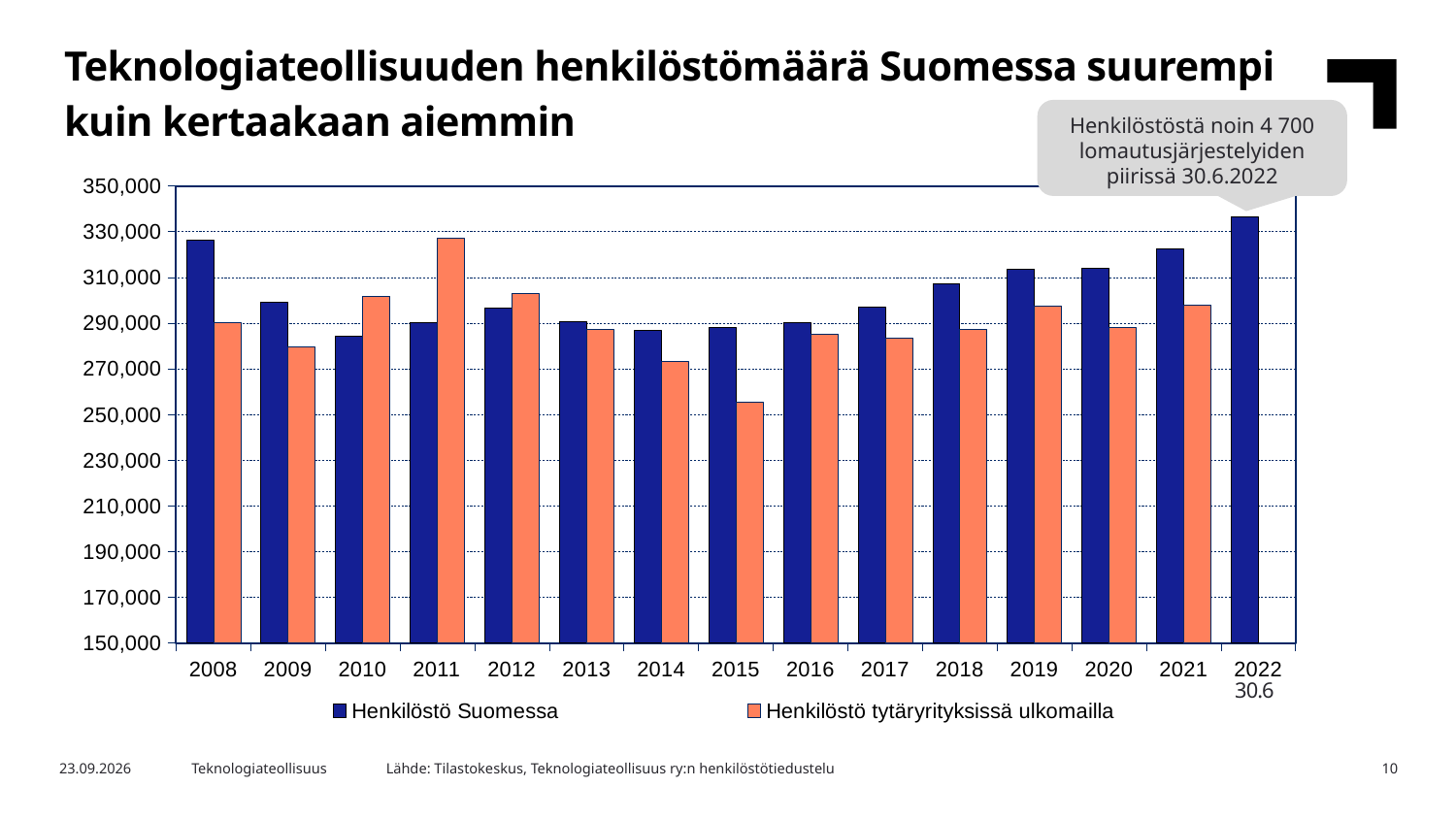
In 2011, which series has the larger value: Henkilöstö Suomessa or Henkilöstö tytäryrityksissä ulkomailla? Henkilöstö tytäryrityksissä ulkomailla Does the value for Henkilöstö Suomessa rise or fall from 2015 to 2022? rise What kind of chart is shown on the slide? bar chart Is the value for Henkilöstö tytäryrityksissä ulkomailla in 2014 greater or less than 290,000? less Is the value for Henkilöstö Suomessa in 2022 greater or less than 330,000? greater How many series does the legend list? 2 In which year is the value for Henkilöstö Suomessa highest? 2022 In which year is the value for Henkilöstö tytäryrityksissä ulkomailla lowest? 2015 Is the value for Henkilöstö tytäryrityksissä ulkomailla in 2015 greater or less than 270,000? less What are the two legend entries of the chart? Henkilöstö Suomessa; Henkilöstö tytäryrityksissä ulkomailla How many years are shown on the x axis? 15 In which year is the value for Henkilöstö tytäryrityksissä ulkomailla highest? 2011